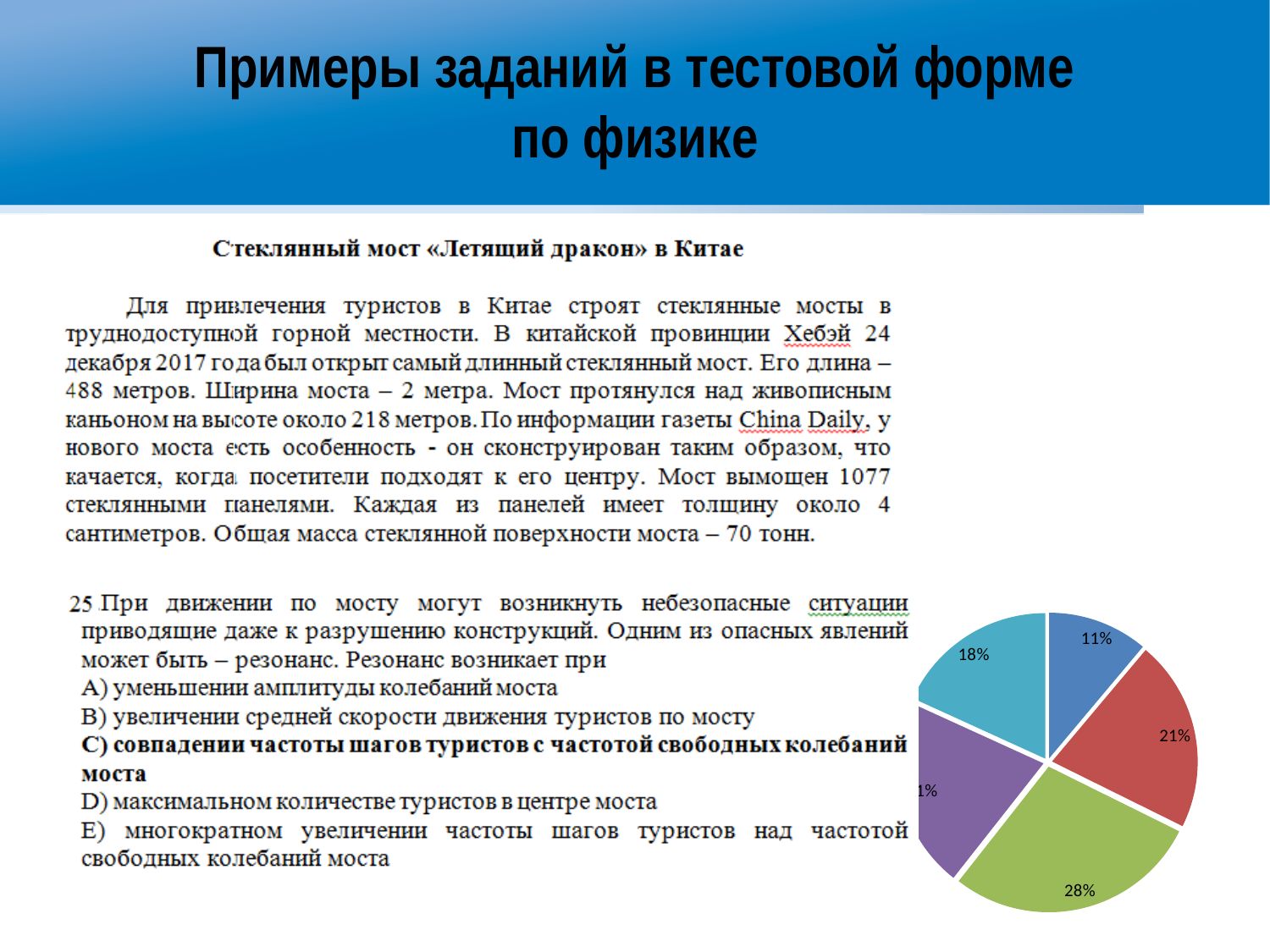
What kind of chart is shown on the slide? pie chart Which is larger in the pie chart, the red slice or the light blue slice? the red slice Which slice of the pie chart is the smallest? the blue slice (11%) How many slices does the pie chart have? 5 By how many percentage points does the red slice exceed the light blue slice? 3 What percentage is shown on the green slice of the pie chart? 28% What percentage is shown on the light blue (teal) slice of the pie chart? 18% What percentage is shown on the blue slice of the pie chart? 11% What percentage is shown on the red slice of the pie chart? 21% Does the pie chart have a legend? No By how many percentage points is the green slice larger than the blue slice? 17 Which slice of the pie chart is the largest? the green slice (28%)